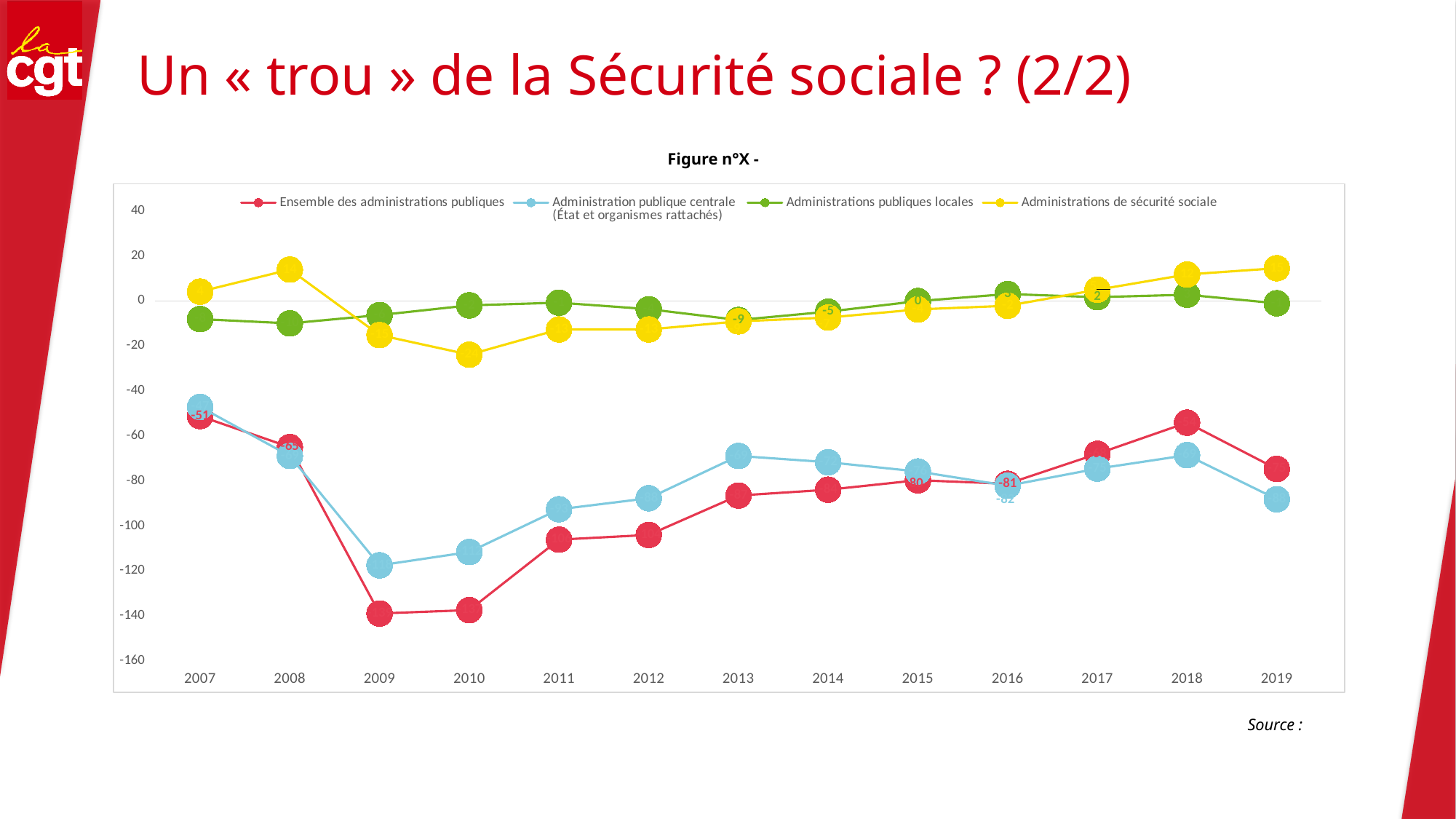
What is the value for Ensemble des administrations publiques in 2016? -81 In 2009, which is higher: Ensemble des administrations publiques or Administration publique centrale? Administration publique centrale Is the value for Administration publique centrale in 2009 greater or less than -100? less What is the value for Administrations publiques locales in 2014? -5 Is the value for Ensemble des administrations publiques in 2009 greater or less than -120? less What kind of chart is shown on the slide? line chart How many years are shown on the x axis? 13 What is the difference between the Ensemble des administrations publiques values in 2007 and 2016? 30 What is the value for Ensemble des administrations publiques in 2007? -51 Is the value for Administrations de sécurité sociale in 2010 greater or less than -20? less Does the Ensemble des administrations publiques series rise or fall from 2010 to 2015? rise How many series does the legend list? 4